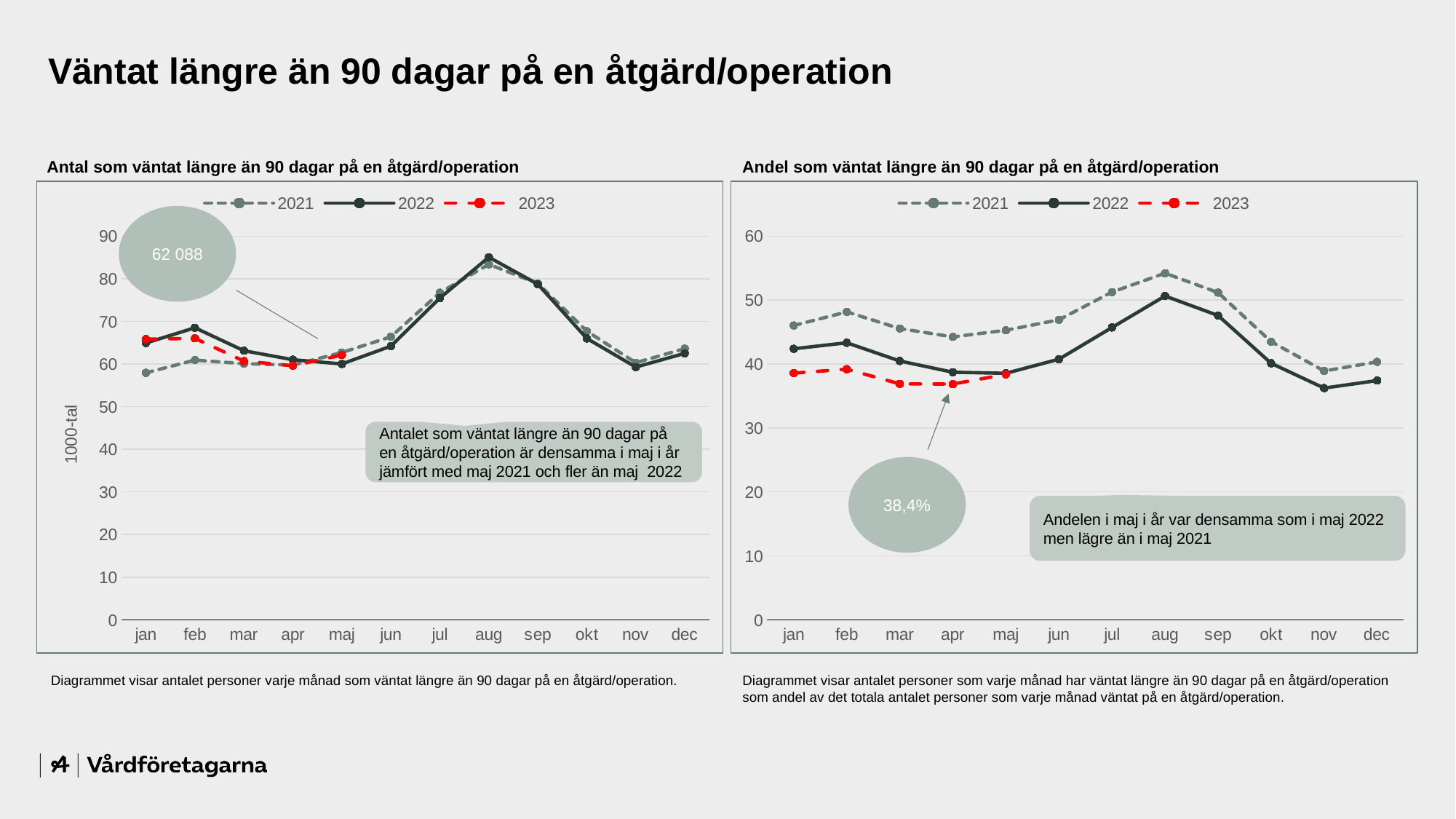
In the right chart, 'Andel som väntat längre än 90 dagar på en åtgärd/operation', does the 2022 series rise or fall from aug to nov? Fall In the left chart, 'Antal som väntat längre än 90 dagar på en åtgärd/operation', what value does the callout give for May 2023? 62 088 What kind of chart is the left chart, 'Antal som väntat längre än 90 dagar på en åtgärd/operation'? Line chart In the right chart, 'Andel som väntat längre än 90 dagar på en åtgärd/operation', which series has the higher value in aug, 2021 or 2022? 2021 How many months are shown on the x axis of the left chart, 'Antal som väntat längre än 90 dagar på en åtgärd/operation'? 12 What is the label on the y axis of the left chart, 'Antal som väntat längre än 90 dagar på en åtgärd/operation'? 1000-tal In the right chart, 'Andel som väntat längre än 90 dagar på en åtgärd/operation', is the 2021 value for aug greater or less than 50? greater How many series does the legend of the right chart, 'Andel som väntat längre än 90 dagar på en åtgärd/operation', list? 3 In the left chart, 'Antal som väntat längre än 90 dagar på en åtgärd/operation', in which month does the 2022 series reach its highest value? aug In the right chart, 'Andel som väntat längre än 90 dagar på en åtgärd/operation', what value does the callout give for May 2023? 38,4% In the left chart, 'Antal som väntat längre än 90 dagar på en åtgärd/operation', is the 2022 value for aug greater or less than 80? greater In the right chart, 'Andel som väntat längre än 90 dagar på en åtgärd/operation', in which month does the 2022 series reach its lowest value? nov